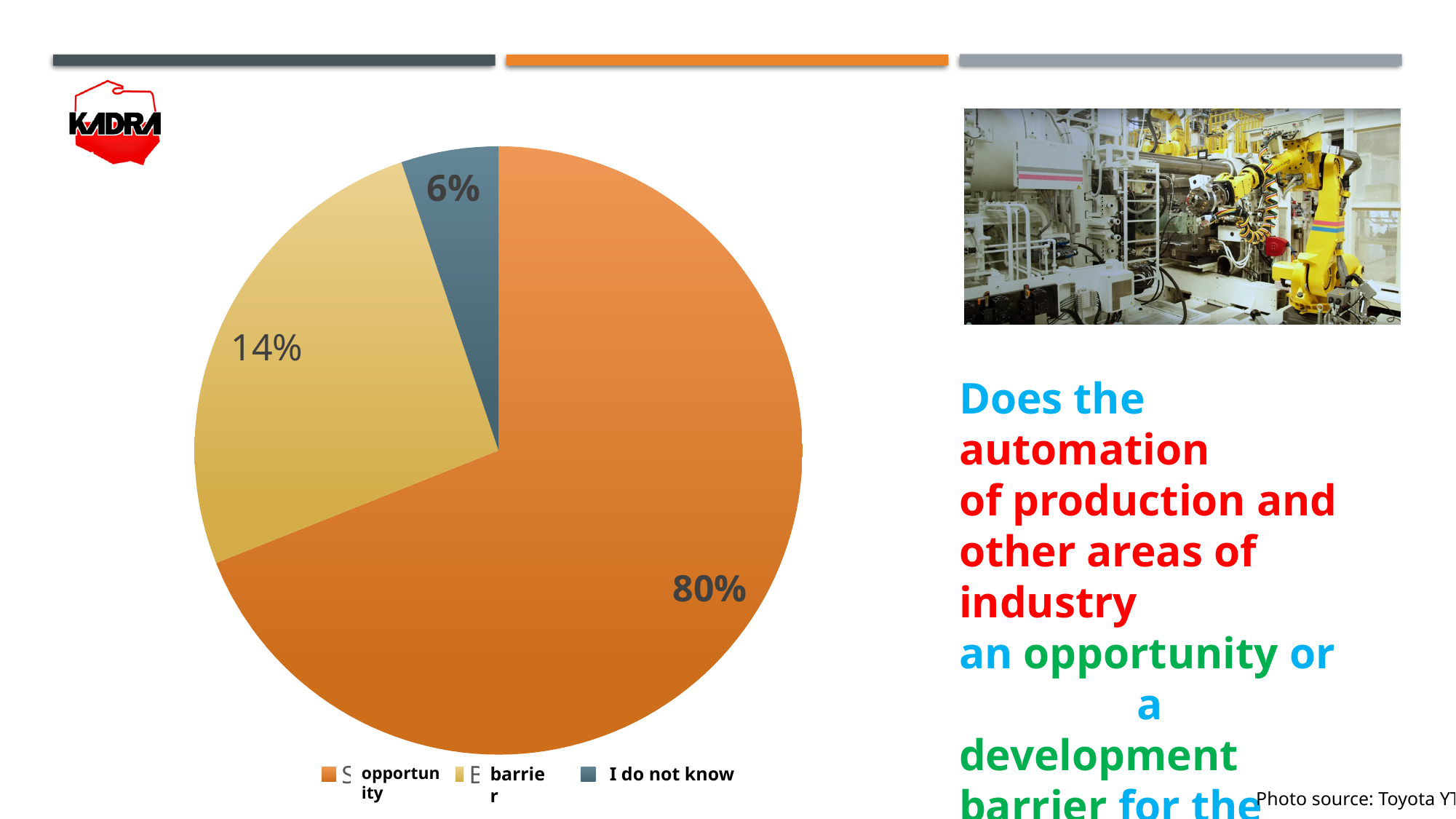
Which slice of the pie is the smallest? I do not know Which slice of the pie is the largest? opportunity What kind of chart is shown on the slide? pie chart How many entries does the legend list? 3 What is the difference in percentage points between the "opportunity" and "barrier" slices? 66 Which is larger, the "barrier" slice or the "I do not know" slice? barrier What share of the pie does the "opportunity" slice represent? 80% What share of the pie does the "barrier" slice represent? 14% How many slices does the pie chart have? 3 What colour is the "opportunity" slice of the pie? orange What share of the pie does the "I do not know" slice represent? 6% What is the difference in percentage points between the "barrier" and "I do not know" slices? 8